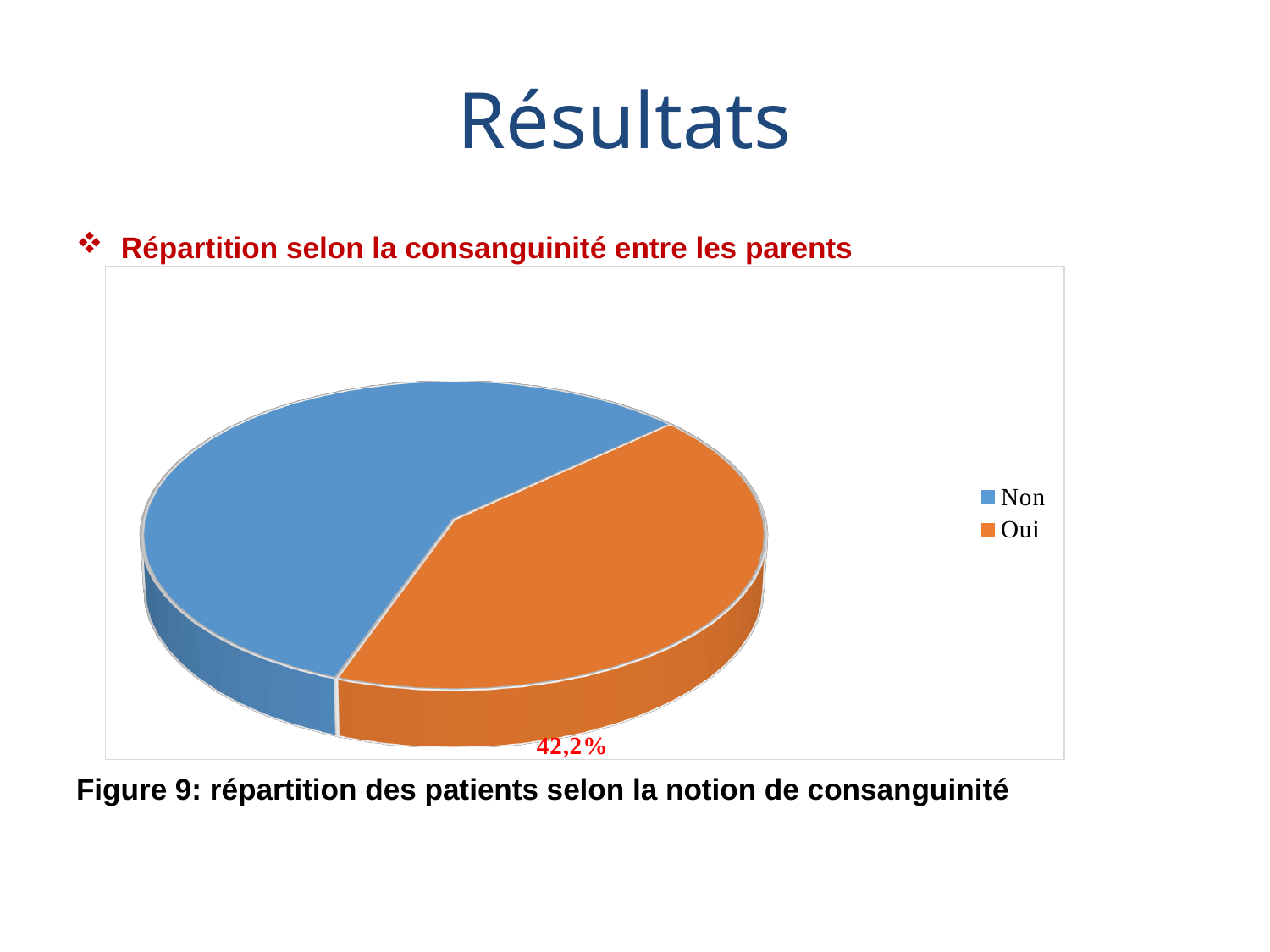
What percentage is printed for the "Oui" slice of the pie chart? 42,2% What colour is the "Non" slice in the pie chart? blue Which slice of the pie chart is the smallest? Oui How many slices does the pie chart have? 2 What are the two legend entries of the pie chart? Non, Oui How many entries does the legend of the pie chart list? 2 What kind of chart is shown on the slide? pie chart Which slice of the pie chart is the largest? Non Is the share of the "Oui" slice greater or less than 50%? less Which is larger in the pie chart, the "Non" slice or the "Oui" slice? Non Is the share of the "Non" slice greater or less than 50%? greater